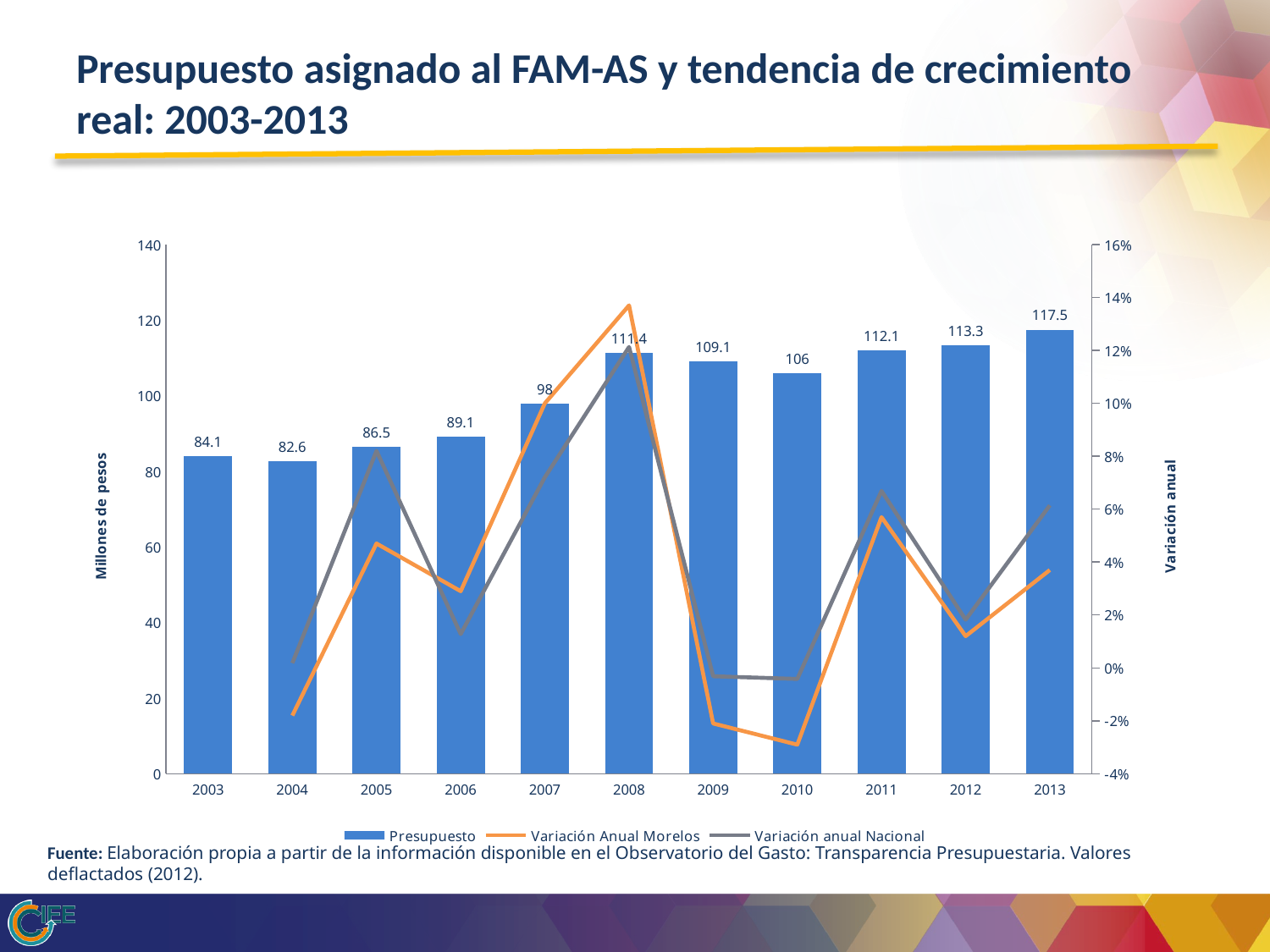
How many years are shown on the x axis? 11 Is the Variación Anual Morelos value for 2010 greater or less than -2%? less Which is larger, the Presupuesto for 2008 or for 2009? 2008 Is the Variación Anual Morelos value for 2008 greater or less than 12%? greater How many series does the legend list? 3 What is the difference between the Presupuesto values for 2013 and 2003? 33.4 Which year has the highest Presupuesto bar? 2013 What kind of chart is shown on the slide? Combined bar and line chart What is the Presupuesto value for 2010? 106 Which year has the lowest Presupuesto bar? 2004 What is the title of the left vertical axis? Millones de pesos What is the Presupuesto value for 2007? 98